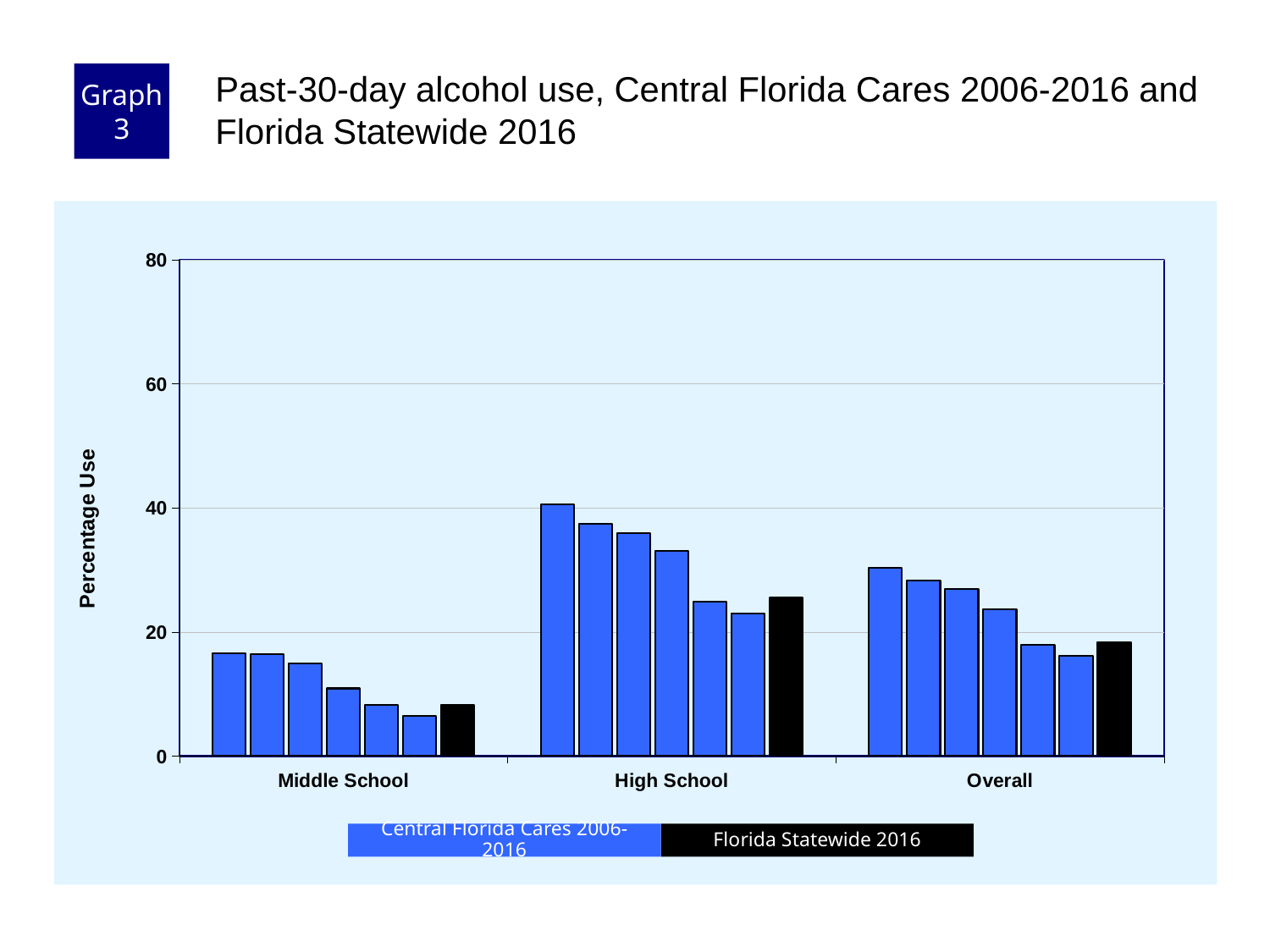
Within each category, do the Central Florida Cares 2006-2016 bars rise or fall from left to right? fall What kind of chart is shown on the slide? bar chart How many categories are shown on the x axis? 3 Which category has the lowest bars? Middle School Is the first Central Florida Cares bar for Overall greater or less than 20? greater Which category has the highest bars? High School Is the Florida Statewide 2016 value for High School greater or less than 20? greater How many series does the legend list? 2 Is the first Central Florida Cares bar for Overall greater or less than 40? less Which is larger, the Florida Statewide 2016 value for High School or for Middle School? High School What is the label on the y axis? Percentage Use